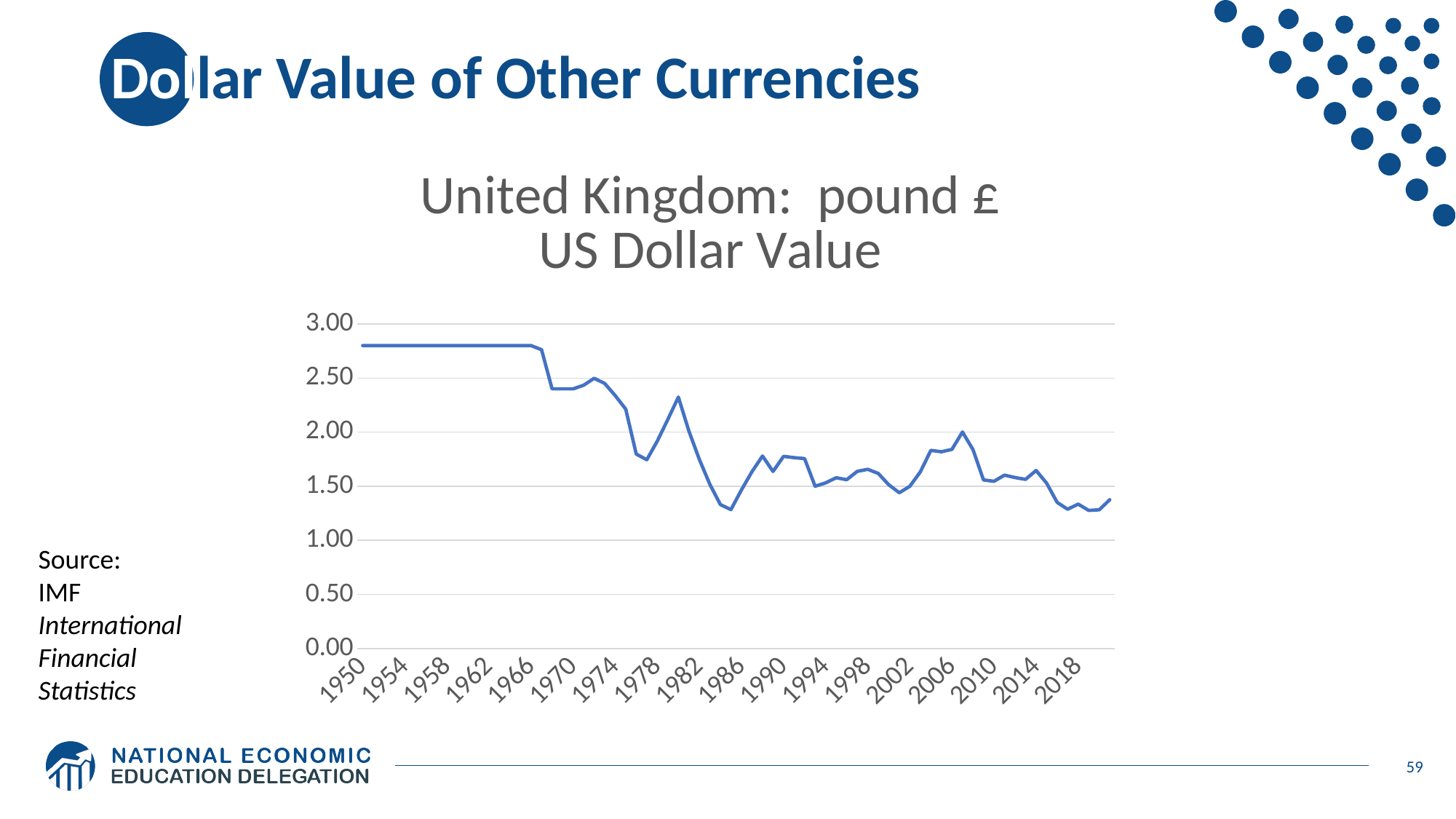
Overall, does the US dollar value of the pound rise or fall from 1950 to 2018? fall What is the highest value shown on the y axis? 3.00 Is the value for 1978 greater or less than 2.00? less What kind of chart is shown on the slide? line chart Is the value for 1982 greater or less than 2.00? less Which year has the larger value, 1970 or 1978? 1970 Is the value for 1950 greater or less than 2.50? greater How many year labels are shown on the x axis? 18 What is the title of the chart? United Kingdom: pound £ US Dollar Value Which year has the larger value, 1950 or 2018? 1950